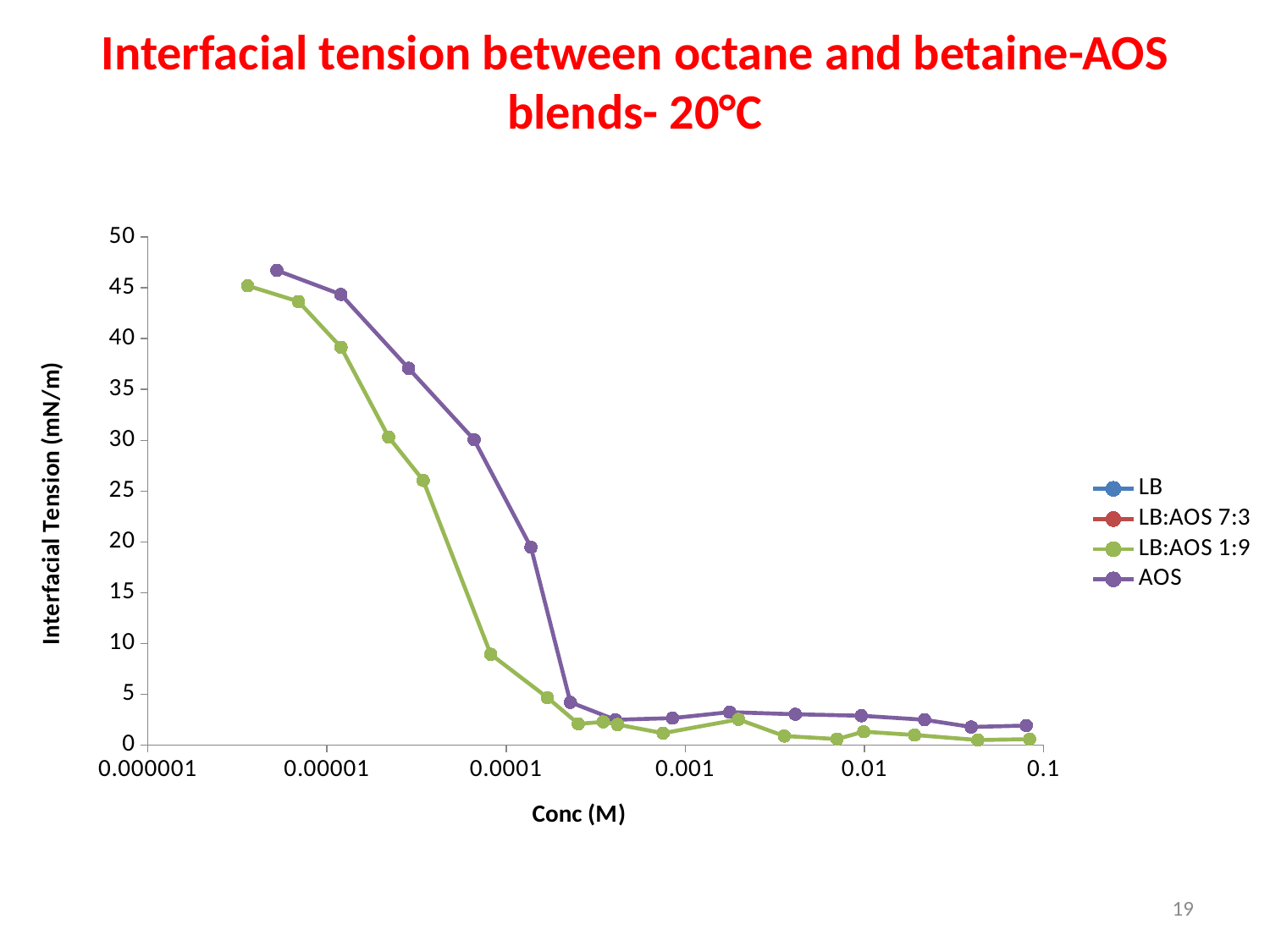
What is the label of the y axis? Interfacial Tension (mN/m) Which series reaches the highest interfacial tension value on the chart? AOS What is the title of the chart? Interfacial tension between octane and betaine-AOS blends- 20°C At the lowest concentrations plotted, which series has the higher interfacial tension, AOS or LB:AOS 1:9? AOS Is the value of the AOS series at its highest concentration (near 0.1 M) greater or less than 5? less How many series does the legend list? 4 What kind of chart is shown on the slide? line chart Is the highest value of the AOS series greater or less than 45? greater Is the highest value of the LB:AOS 1:9 series greater or less than 50? less Do the interfacial tension values rise or fall as concentration increases along the x axis? fall At a concentration of about 0.01 M, which series has the lower interfacial tension, AOS or LB:AOS 1:9? LB:AOS 1:9